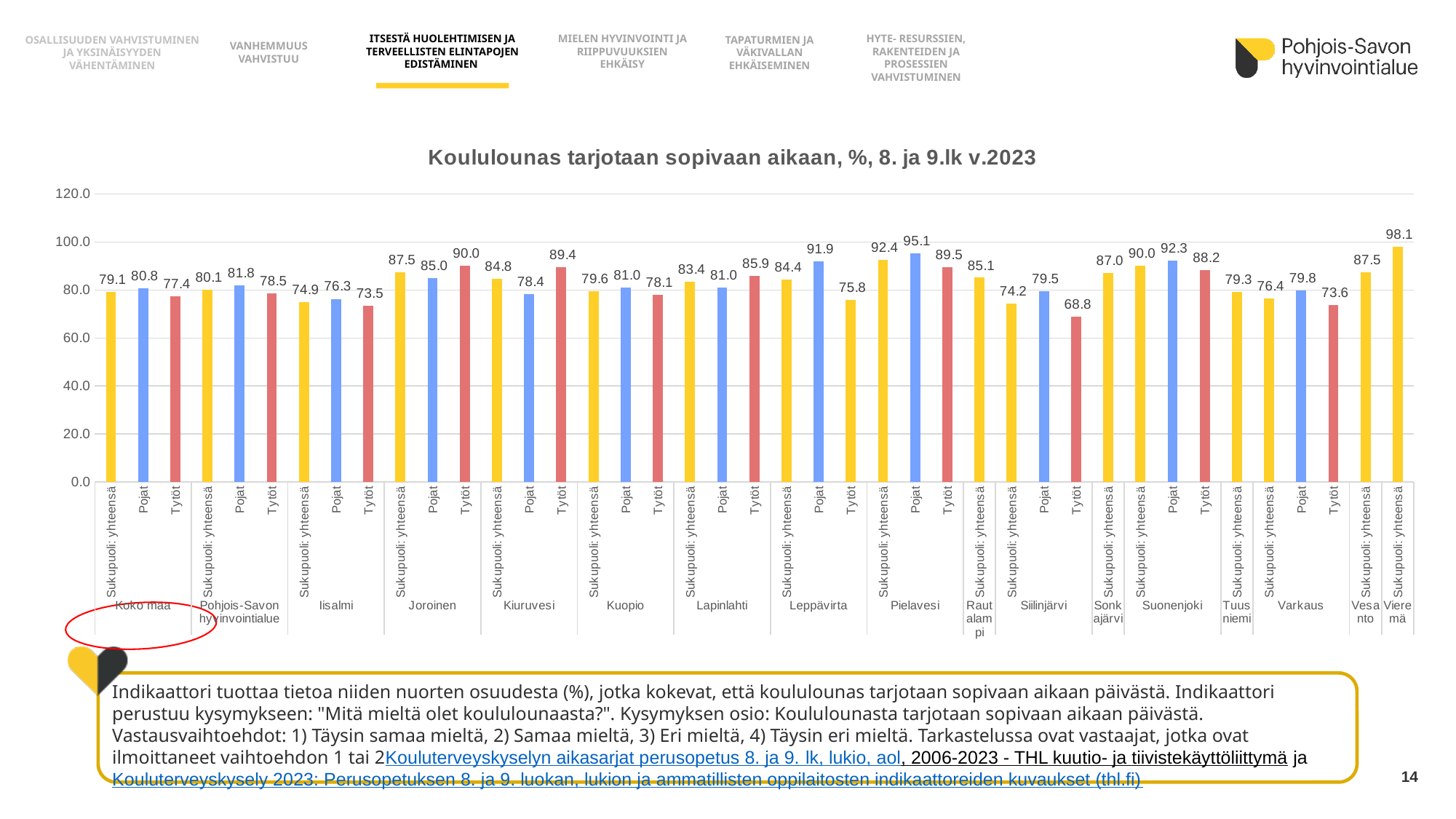
What type of chart is shown on the slide? Bar chart What is the value for Tytöt in Siilinjärvi? 68.8 What is the value for Sukupuoli: yhteensä in Vieremä? 98.1 Which bar has the lowest value in the chart? Siilinjärvi, Tytöt (68.8) Which bar has the highest value in the chart? Vieremä, Sukupuoli: yhteensä (98.1) What is the title of the chart? Koululounas tarjotaan sopivaan aikaan, %, 8. ja 9.lk v.2023 How many municipality/area groups are shown on the x axis? 17 Is the value for Pojat in Suonenjoki greater or less than 80? greater What is the value for Pojat in Pielavesi? 95.1 What is the value for Sukupuoli: yhteensä in Koko maa? 79.1 What is the difference between Pojat and Tytöt in Leppävirta? 16.1 Which is larger in Joroinen, Pojat or Tytöt? Tytöt